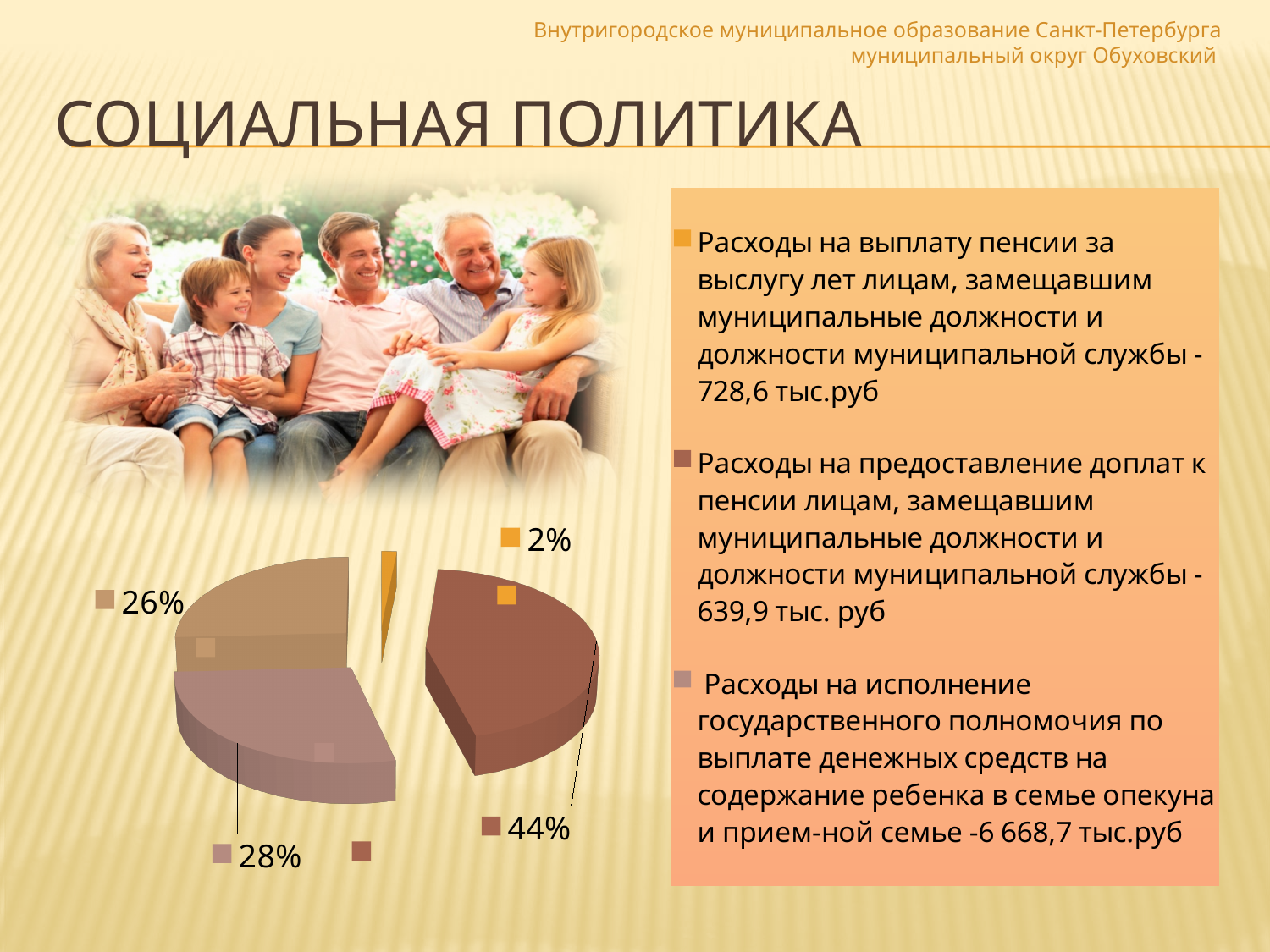
What share does the dark brown slice of the pie chart represent? 44% What is the difference between the largest slice (44%) and the smallest slice (2%) in the pie chart? 42% Is the pie chart drawn in 3D or flat 2D? 3D What share does the tan (light brown) slice of the pie chart represent? 26% How many slices does the pie chart have? 4 Which slice is larger in the pie chart, the one labelled 28% or the one labelled 26%? 28% What kind of chart is shown on the slide? pie chart What is the largest share shown in the pie chart? 44% What is the smallest share shown in the pie chart? 2% What share does the small orange slice of the pie chart represent? 2% What is the difference between the 28% slice and the 26% slice in the pie chart? 2% What is the combined share of the 44% and 28% slices in the pie chart? 72%